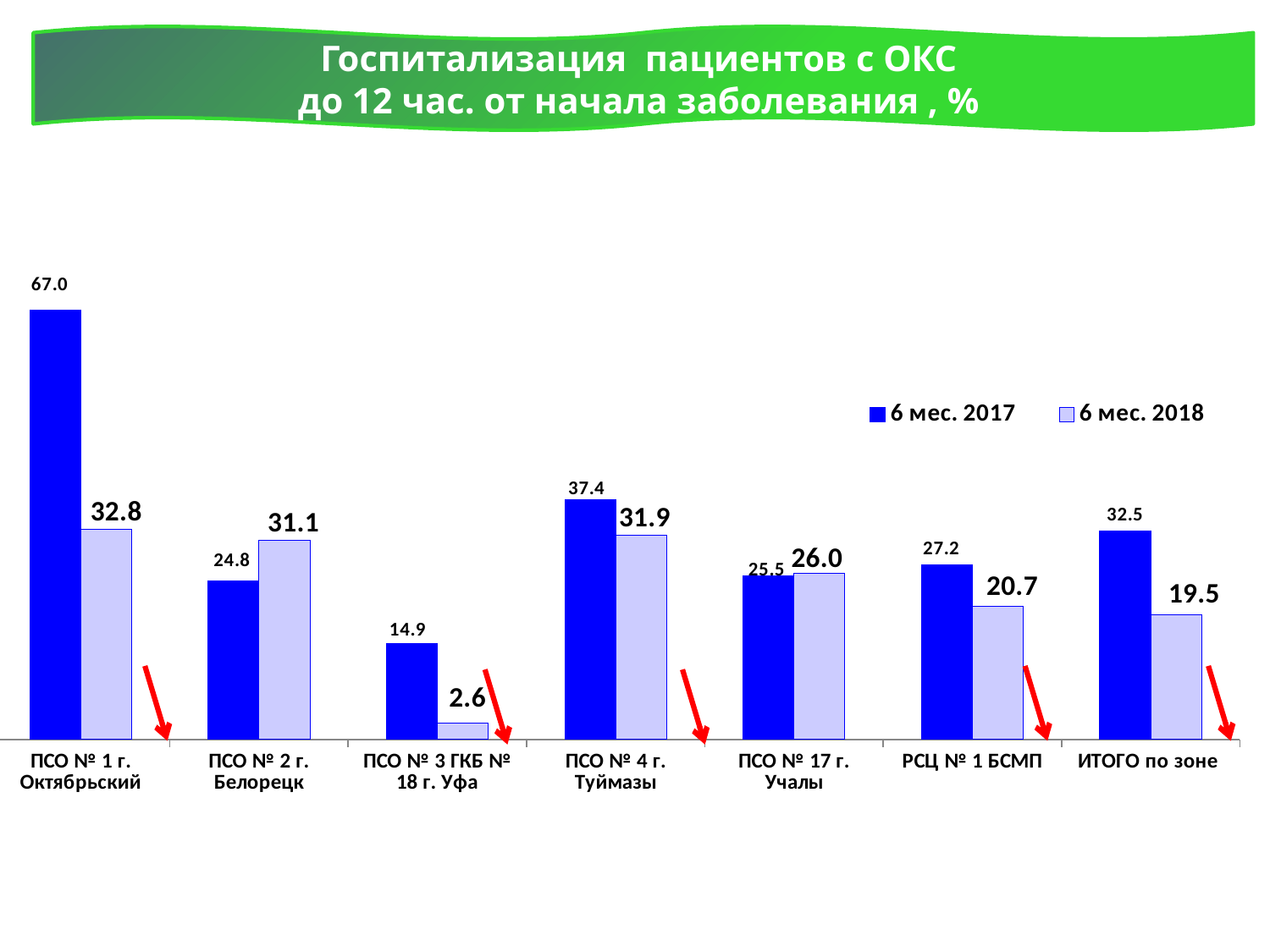
What is the value for ИТОГО по зоне in the 6 мес. 2018 series? 19.5 For ПСО № 2 г. Белорецк, which series has the larger value, 6 мес. 2017 or 6 мес. 2018? 6 мес. 2018 Which category has the highest value in the 6 мес. 2017 series? ПСО № 1 г. Октябрьский What is the difference between the 6 мес. 2017 and 6 мес. 2018 values for ПСО № 4 г. Туймазы? 5.5 How many series does the legend list? 2 What is the value for ПСО № 1 г. Октябрьский in the 6 мес. 2017 series? 67.0 What is the value for РСЦ № 1 БСМП in the 6 мес. 2017 series? 27.2 What kind of chart is shown on the slide? Bar chart Which category has the lowest value in the 6 мес. 2018 series? ПСО № 3 ГКБ № 18 г. Уфа What is the difference between the 6 мес. 2017 and 6 мес. 2018 values for ПСО № 1 г. Октябрьский? 34.2 How many categories are shown on the x axis? 7 What is the value for ПСО № 3 ГКБ № 18 г. Уфа in the 6 мес. 2018 series? 2.6